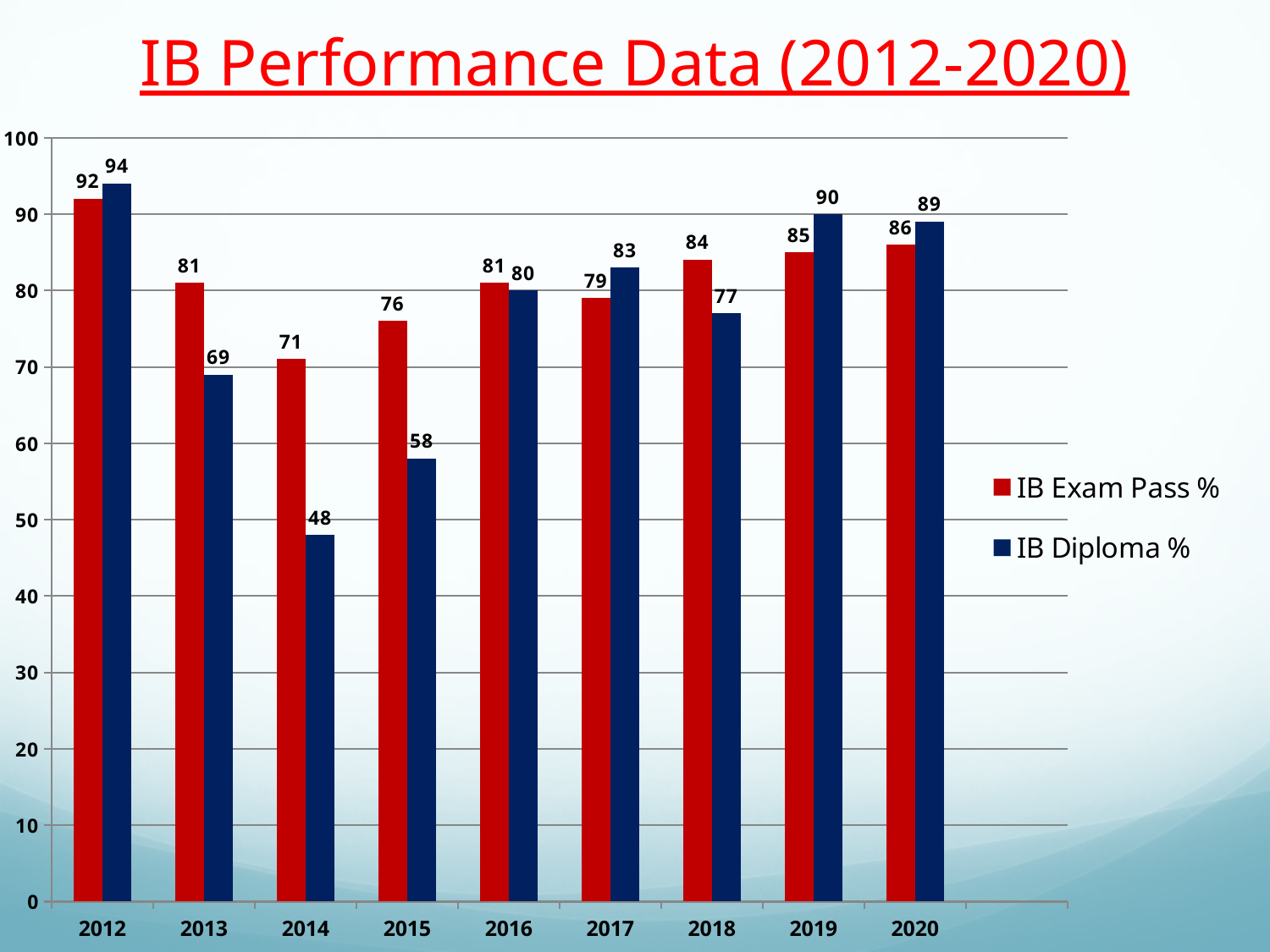
Which is larger in 2017, the IB Exam Pass % or the IB Diploma %? IB Diploma % How many series does the legend list? 2 What is the IB Diploma % value for 2019? 90 What is the IB Exam Pass % value for 2014? 71 What is the difference between the IB Exam Pass % and IB Diploma % values in 2014? 23 What colour are the IB Diploma % bars? Dark blue Which year has the highest IB Diploma % value? 2012 How many years are shown on the x axis? 9 What is the title of the chart? IB Performance Data (2012-2020) What kind of chart is shown on the slide? Bar chart Does the IB Exam Pass % rise or fall from 2014 to 2020? Rise Which year has the lowest IB Exam Pass % value? 2014